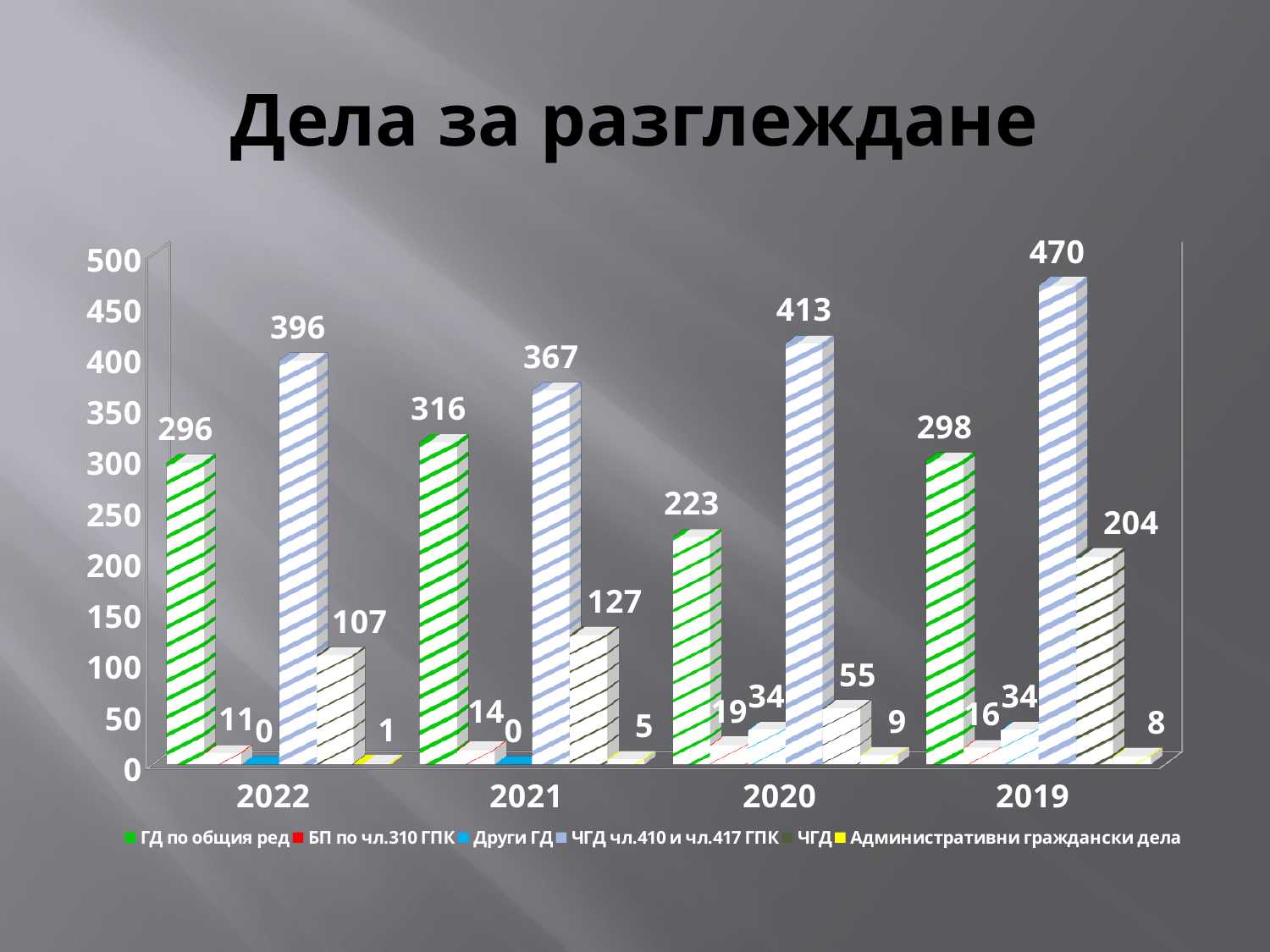
What is the title of the chart? Дела за разглеждане What is the difference between the ЧГД чл.410 и чл.417 ГПК values for 2019 and 2020? 57 What is the value for ЧГД чл.410 и чл.417 ГПК in 2019? 470 What is the value for Административни граждански дела in 2020? 9 What is the value for ЧГД in 2021? 127 How many series does the legend list? 6 How many years are shown on the x axis? 4 In which year is the value for ГД по общия ред lowest? 2020 In which year is the value for ЧГД чл.410 и чл.417 ГПК highest? 2019 What is the value for ГД по общия ред in 2022? 296 Which is larger in 2021: ГД по общия ред or ЧГД чл.410 и чл.417 ГПК? ЧГД чл.410 и чл.417 ГПК What kind of chart is shown on the slide? Bar chart